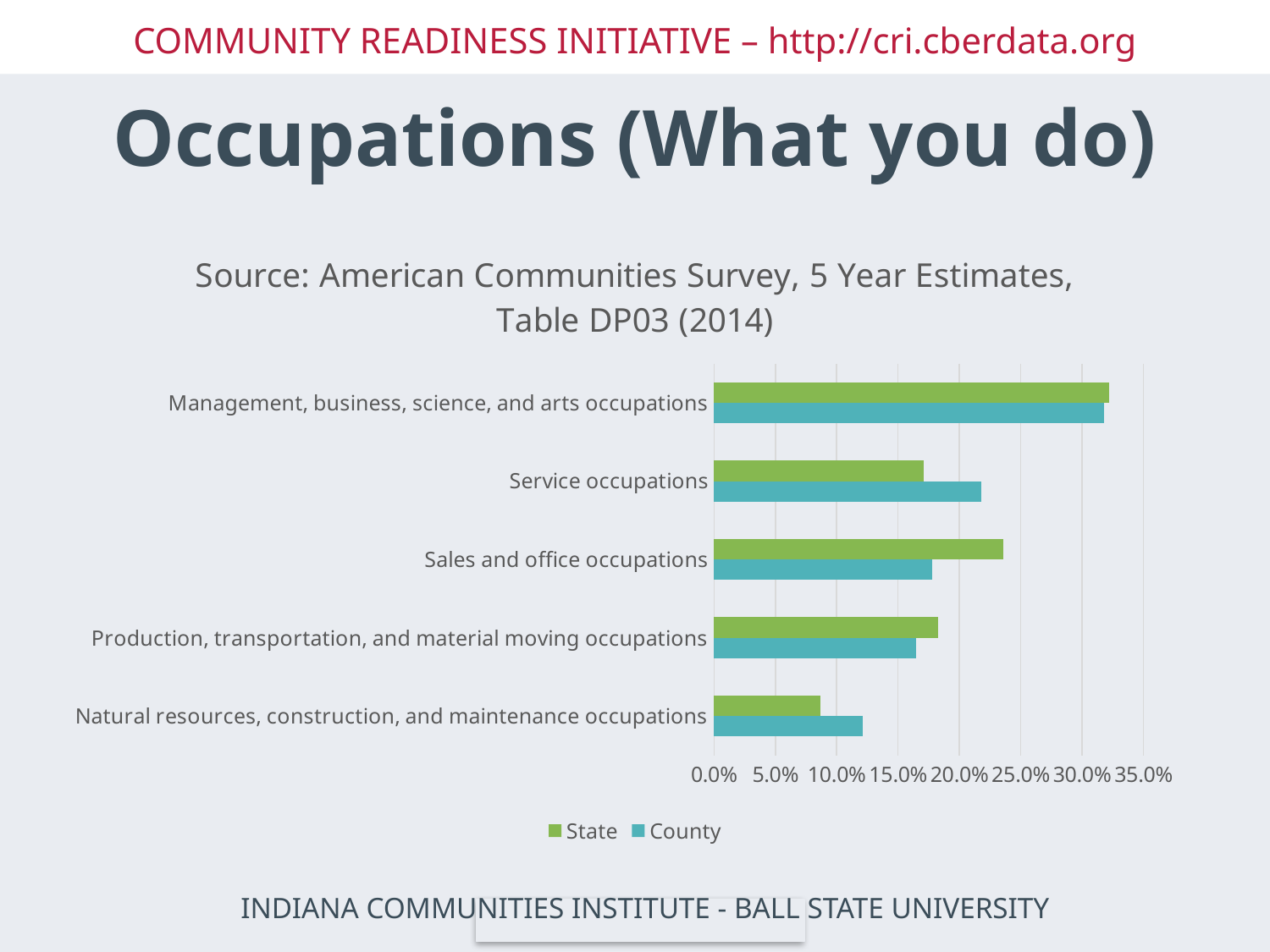
Is the State value for Management, business, science, and arts occupations greater or less than 30.0%? greater Which series is shown in green in the chart legend? State How many series does the chart legend list? 2 Is the State value for Natural resources, construction, and maintenance occupations greater or less than 10.0%? less How many occupation categories are shown in the chart? 5 Which occupation category has the highest State value? Management, business, science, and arts occupations What kind of chart is shown on the slide? Bar chart For Sales and office occupations, which is larger, the State value or the County value? State For Service occupations, which is larger, the State value or the County value? County Which occupation category has the lowest County value? Natural resources, construction, and maintenance occupations For Natural resources, construction, and maintenance occupations, which is larger, the State value or the County value? County Is the County value for Service occupations greater or less than 20.0%? greater